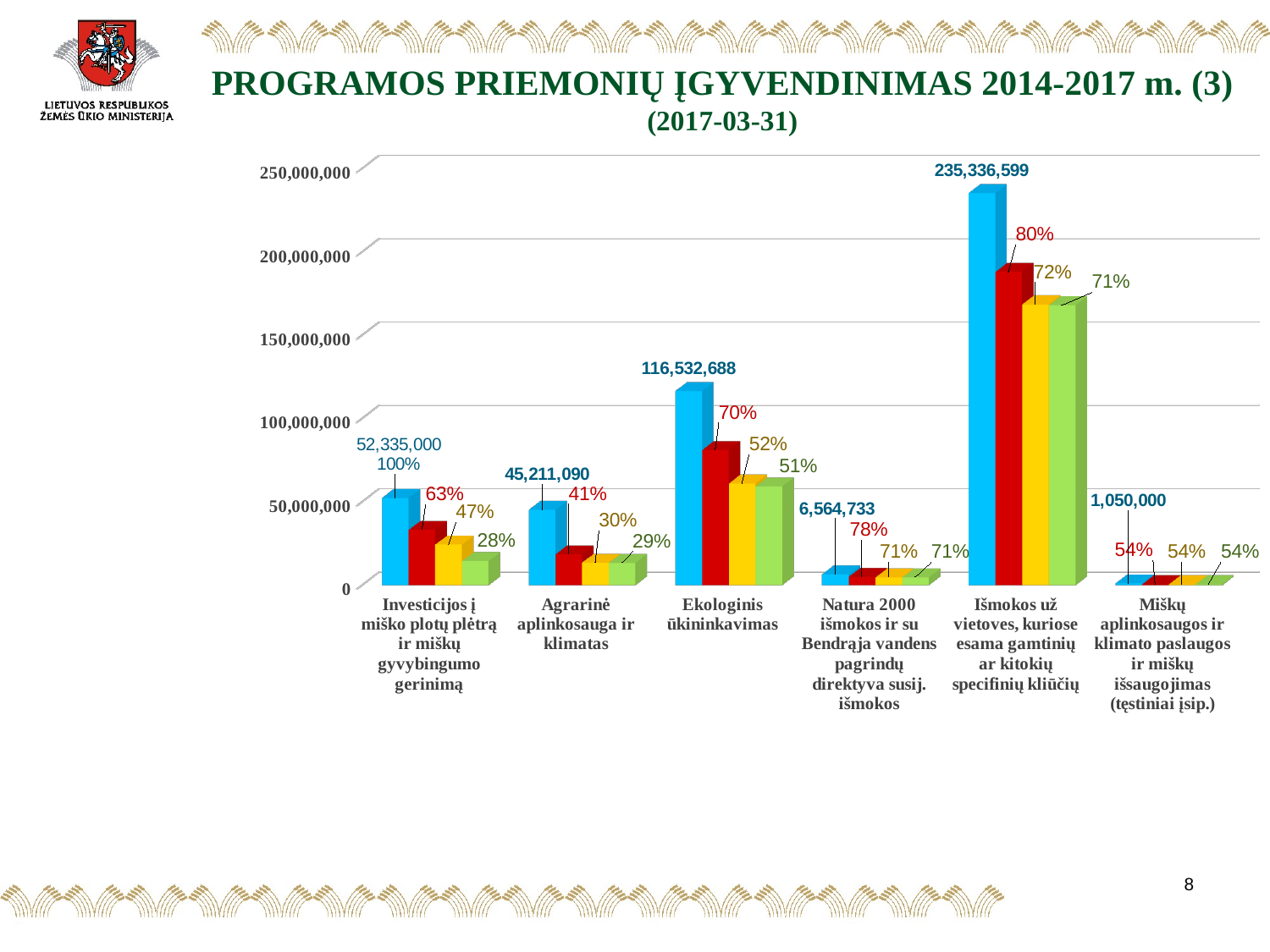
What percentage is printed next to the green bar for Agrarinė aplinkosauga ir klimatas? 29% What kind of chart is shown on the slide? Bar chart What is the difference between the blue bar values for Investicijos į miško plotų plėtrą ir miškų gyvybingumo gerinimą and Agrarinė aplinkosauga ir klimatas? 7,123,910 Which category has the highest blue bar value? Išmokos už vietoves, kuriose esama gamtinių ar kitokių specifinių kliūčių What is the title of the slide containing the chart? PROGRAMOS PRIEMONIŲ ĮGYVENDINIMAS 2014-2017 m. (3) (2017-03-31) What is the value printed above the blue bar for Ekologinis ūkininkavimas? 116,532,688 What percentage is printed next to the red bar for Natura 2000 išmokos ir su Bendrąja vandens pagrindų direktyva susij. išmokos? 78% Is the blue bar value for Ekologinis ūkininkavimas greater or less than 100,000,000? greater What is the value printed above the blue bar for Išmokos už vietoves, kuriose esama gamtinių ar kitokių specifinių kliūčių? 235,336,599 How many categories are shown on the x axis? 6 Which is larger: the red bar percentage for Ekologinis ūkininkavimas or the red bar percentage for Agrarinė aplinkosauga ir klimatas? Ekologinis ūkininkavimas (70%) Which category has the lowest blue bar value? Miškų aplinkosaugos ir klimato paslaugos ir miškų išsaugojimas (tęstiniai įsip.)